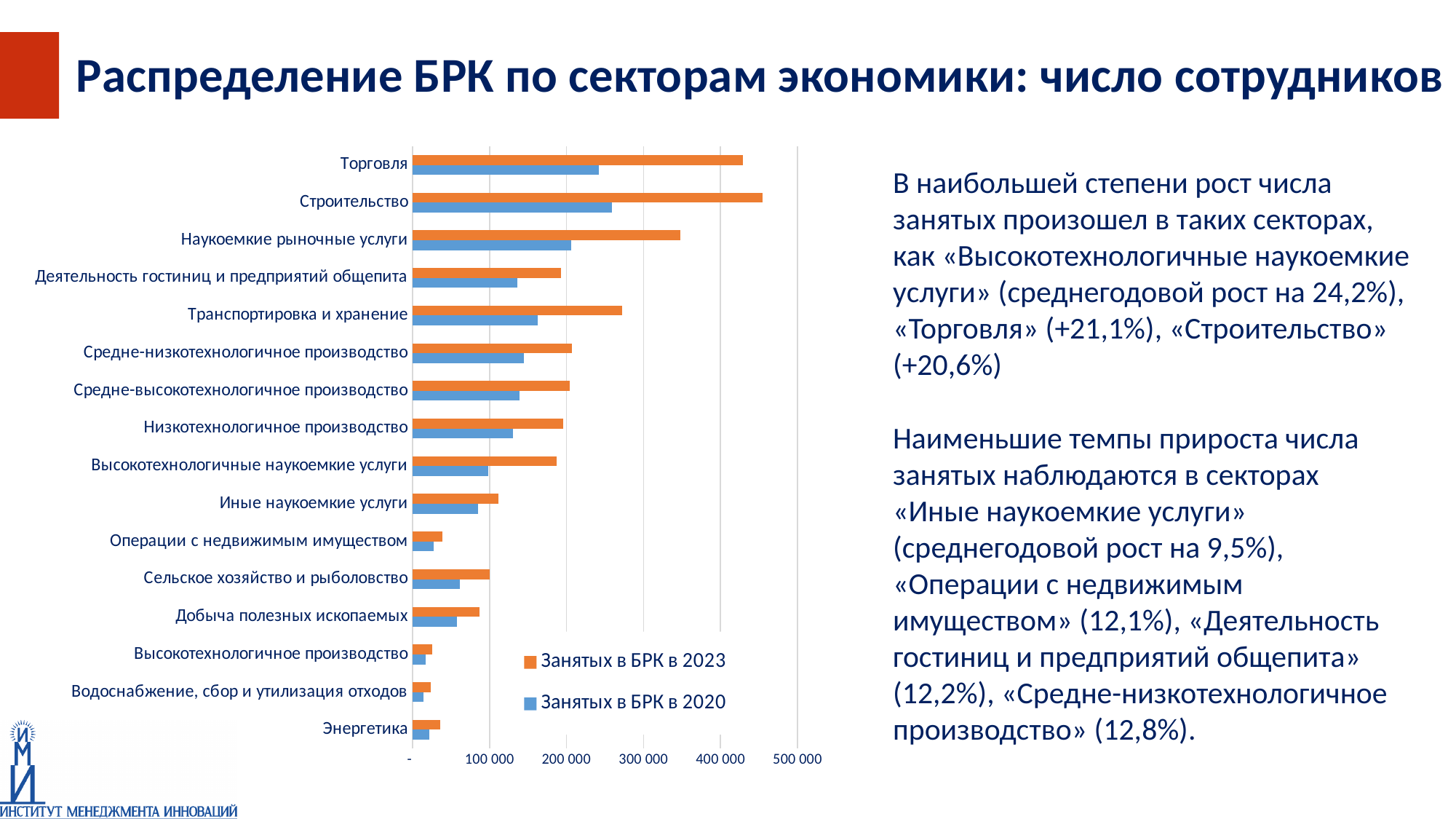
Is the value for Наукоемкие рыночные услуги in the series "Занятых в БРК в 2023" greater or less than 300 000? greater How many series does the chart legend list? 2 Is the value for Энергетика in the series "Занятых в БРК в 2023" greater or less than 100 000? less Is the value for Торговля in the series "Занятых в БРК в 2023" greater or less than 400 000? greater What kind of chart is shown on the slide? bar chart Which sector has the highest value for "Занятых в БРК в 2023"? Строительство What colour are the bars for the series "Занятых в БРК в 2020"? blue In the series "Занятых в БРК в 2023", which is larger: Транспортировка и хранение or Средне-низкотехнологичное производство? Транспортировка и хранение How many economic sectors (categories) are shown on the chart? 16 Which sector has the highest value for "Занятых в БРК в 2020"? Строительство For Торговля, which series has the larger value: "Занятых в БРК в 2023" or "Занятых в БРК в 2020"? Занятых в БРК в 2023